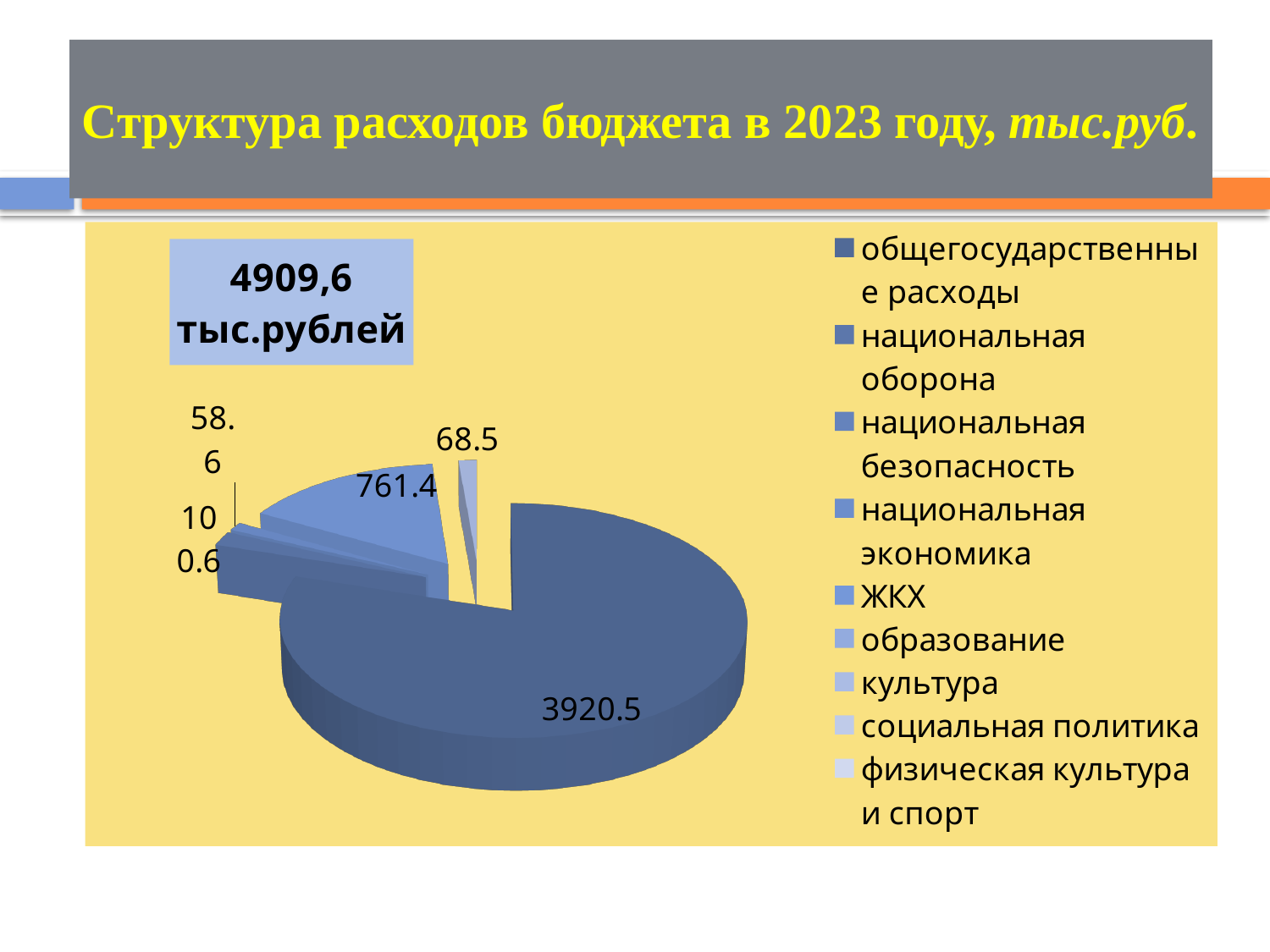
Which category has the largest slice in the pie chart? общегосударственные расходы How many data labels with values are printed on the pie chart? 5 What value is printed on the largest slice of the pie chart? 3920.5 What kind of chart is shown on the slide? Pie chart What is the title of the slide's chart? 4909,6 тыс.рублей How many categories does the legend of the pie chart list? 9 What is the value for общегосударственные расходы in the pie chart? 3920.5 What is the difference between the slice labelled 3920.5 and the slice labelled 761.4? 3159.1 Which is larger, the slice labelled 761.4 or the slice labelled 68.5? 761.4 What is the smallest value printed as a data label on the pie chart? 58.6 What total amount is shown in the box at the top left of the chart? 4909,6 тыс.рублей